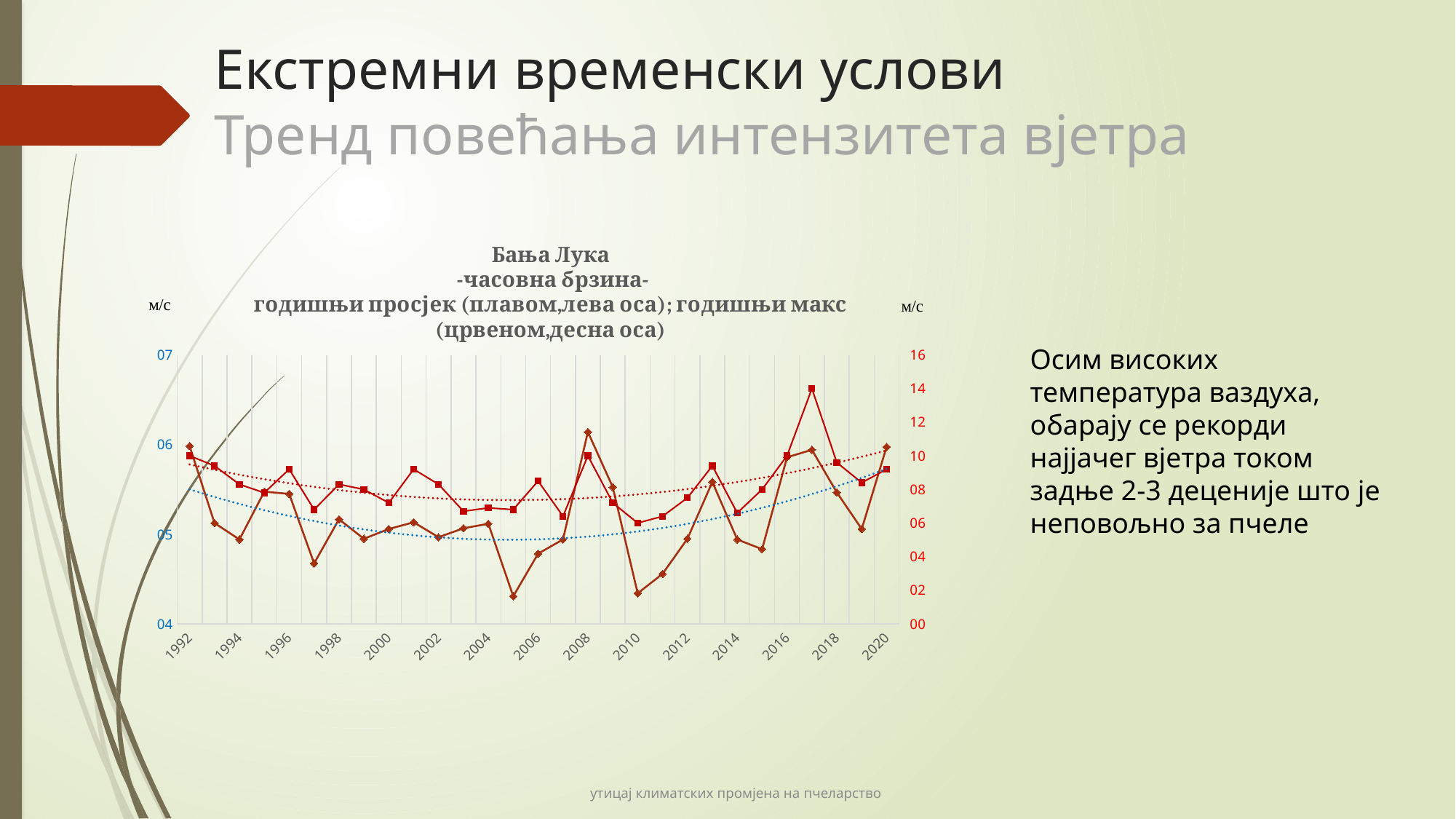
What is the last year shown on the x axis of the chart? 2020 In which year does the annual max (red, right axis) series reach its highest value? 2017 How many years (data points) are plotted along the x axis from 1992 to 2020 inclusive? 29 What unit is shown on both vertical axes of the chart? м/с Which city is named in the chart title? Бања Лука Is the annual average value for 2008 (left axis) greater or less than 6? greater What kind of chart is shown on the slide? line chart Is the annual max value for 2017 (right axis) greater or less than 12? greater How many data series does the chart title describe (annual average and annual max)? 2 Which year has the larger annual max value, 2017 or 2010? 2017 What is the first year shown on the x axis of the chart? 1992 Is the annual average value for 2005 (left axis) greater or less than 5? less